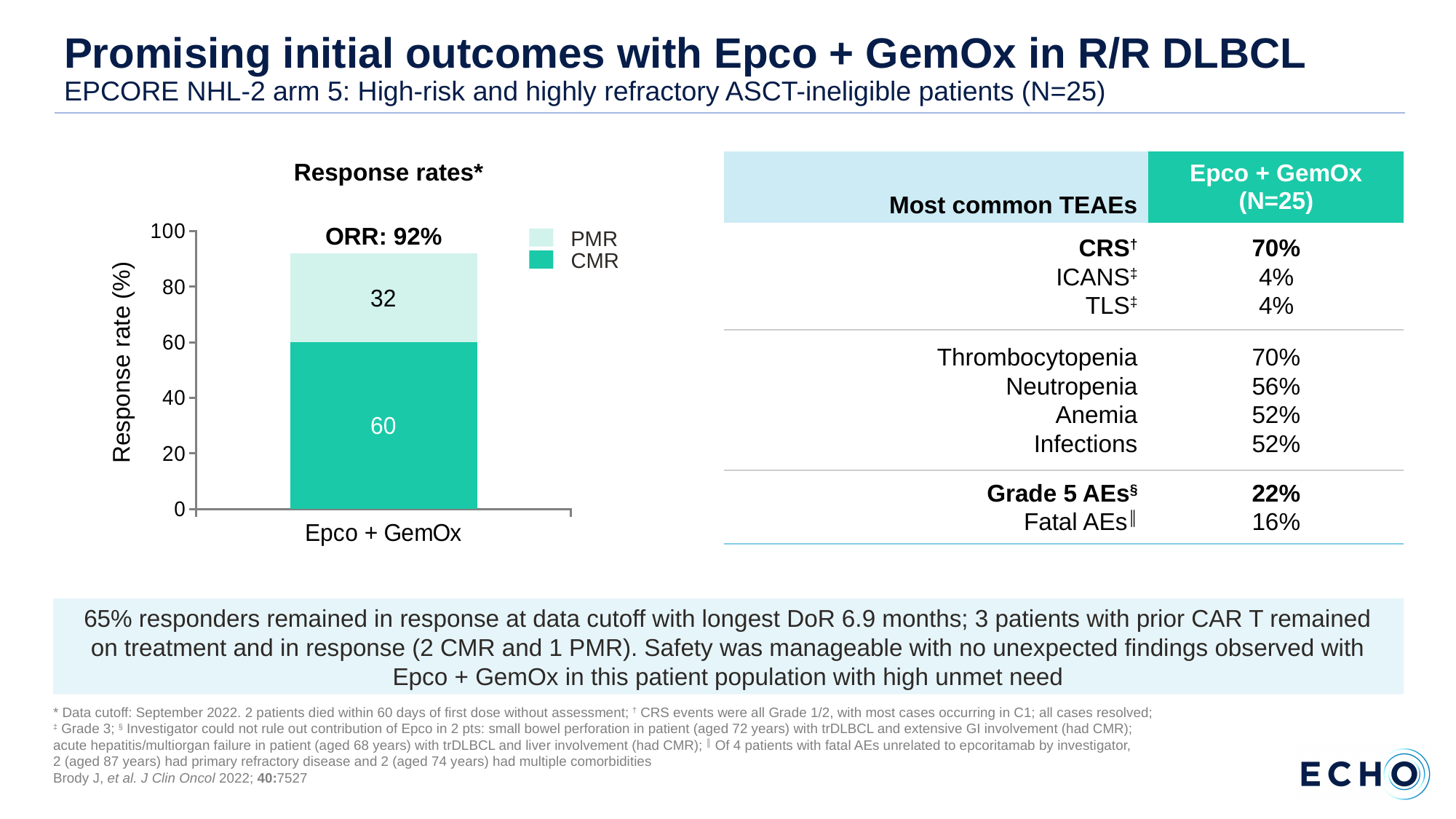
Which segment is larger in the Response rates chart, CMR or PMR? CMR How many categories are shown on the x axis of the Response rates chart? 1 What is the total of the stacked bar for Epco + GemOx in the Response rates chart? 92 What ORR is shown above the bar in the Response rates chart? 92% What is the y-axis label of the Response rates chart? Response rate (%) What is the category label on the x axis of the Response rates chart? Epco + GemOx What is the PMR value for Epco + GemOx in the Response rates chart? 32 Is the CMR value in the Response rates chart greater or less than 40? greater How many series does the legend of the Response rates chart list? 2 What is the CMR value for Epco + GemOx in the Response rates chart? 60 What kind of chart is the Response rates chart? Stacked bar chart What is the difference between the CMR and PMR values in the Response rates chart? 28